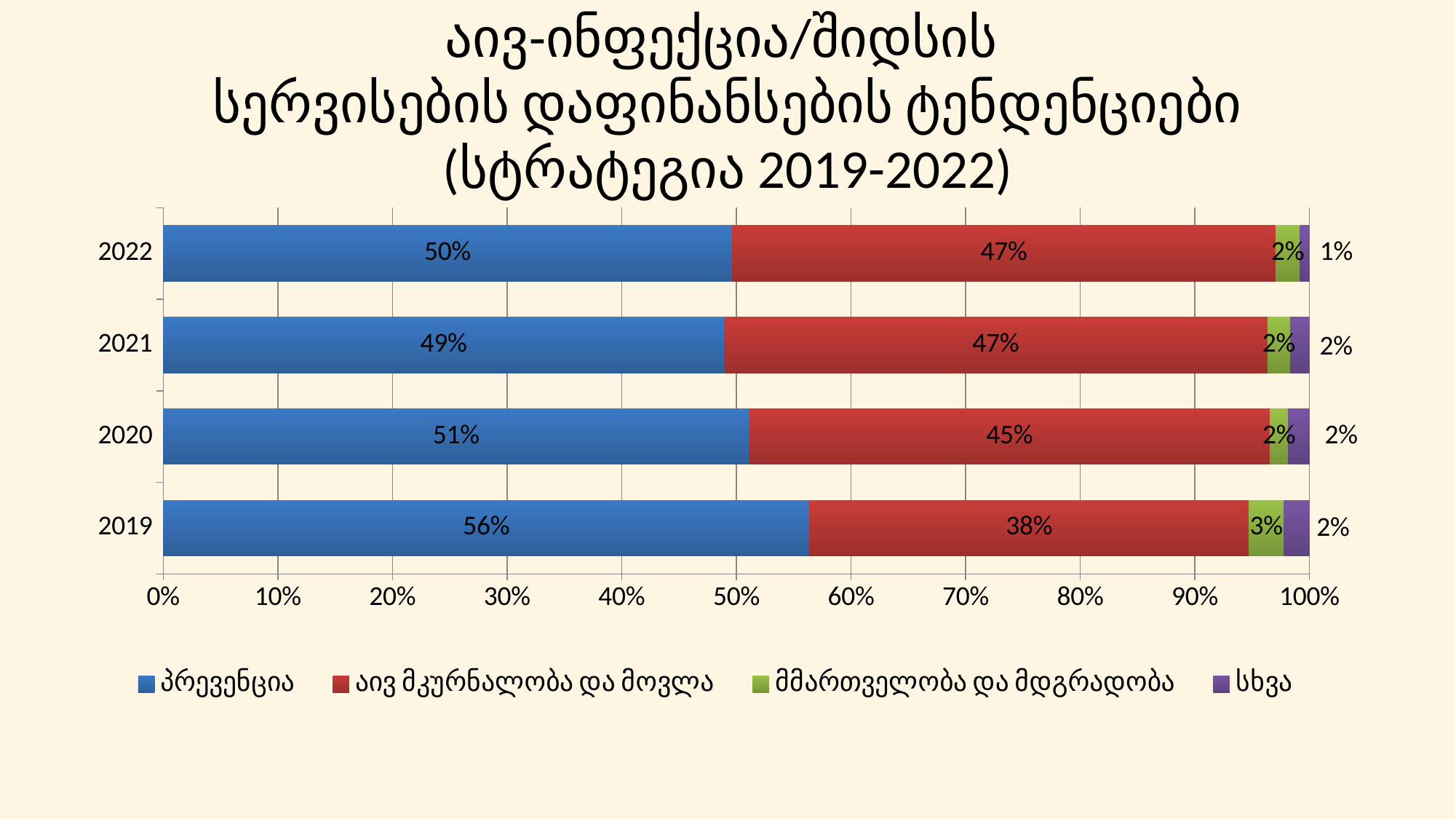
How many years are shown on the chart? 4 What is the value of აივ მკურნალობა და მოვლა for 2020? 45% What type of chart is shown on the slide? Stacked bar chart Which is larger in 2021: პრევენცია or აივ მკურნალობა და მოვლა? პრევენცია Does the აივ მკურნალობა და მოვლა share rise or fall from 2019 to 2022? Rise In which year is the პრევენცია share the highest? 2019 In which year is the აივ მკურნალობა და მოვლა share the lowest? 2019 What is the value of მმართველობა და მდგრადობა for 2019? 3% How many series does the legend list? 4 What is the value of სხვა for 2022? 1% What is the difference between the პრევენცია share in 2019 and in 2022? 6% What is the value of პრევენცია for 2019? 56%